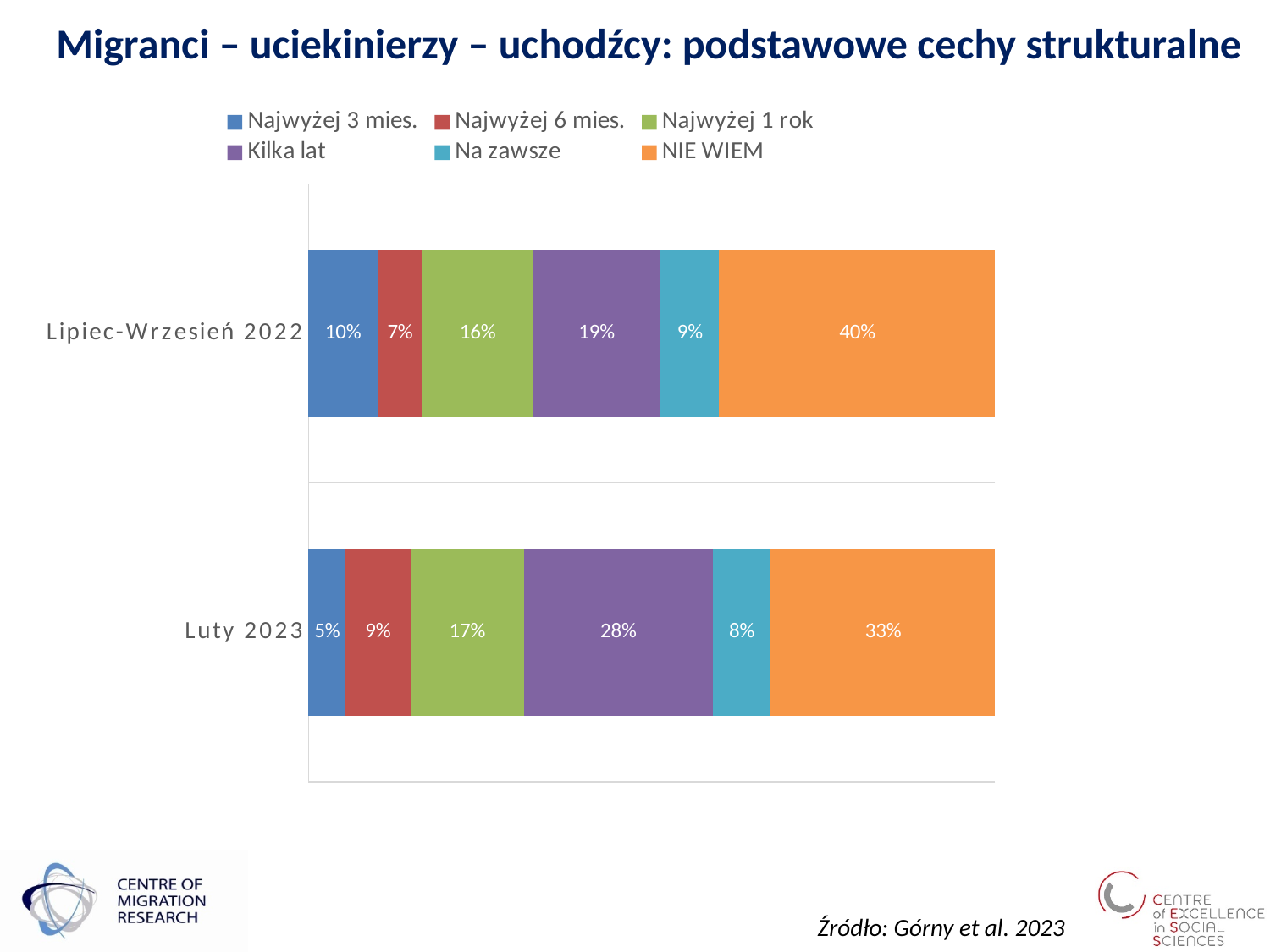
How many series does the legend list? 6 What is the difference between the 'Kilka lat' values for Luty 2023 and Lipiec-Wrzesień 2022? 9% What is the value for 'Na zawsze' in Lipiec-Wrzesień 2022? 9% What is the value for 'Kilka lat' in Luty 2023? 28% Which series has the largest share in the Luty 2023 bar? NIE WIEM Which legend entry is shown in orange? NIE WIEM What is the value for 'NIE WIEM' in Lipiec-Wrzesień 2022? 40% What is the value for 'Najwyżej 3 mies.' in Luty 2023? 5% Which series has the smallest share in the Lipiec-Wrzesień 2022 bar? Najwyżej 6 mies. Is the 'NIE WIEM' share larger in Lipiec-Wrzesień 2022 or in Luty 2023? Lipiec-Wrzesień 2022 How many categories (bars) are shown in the chart? 2 What kind of chart is shown on the slide? Stacked bar chart